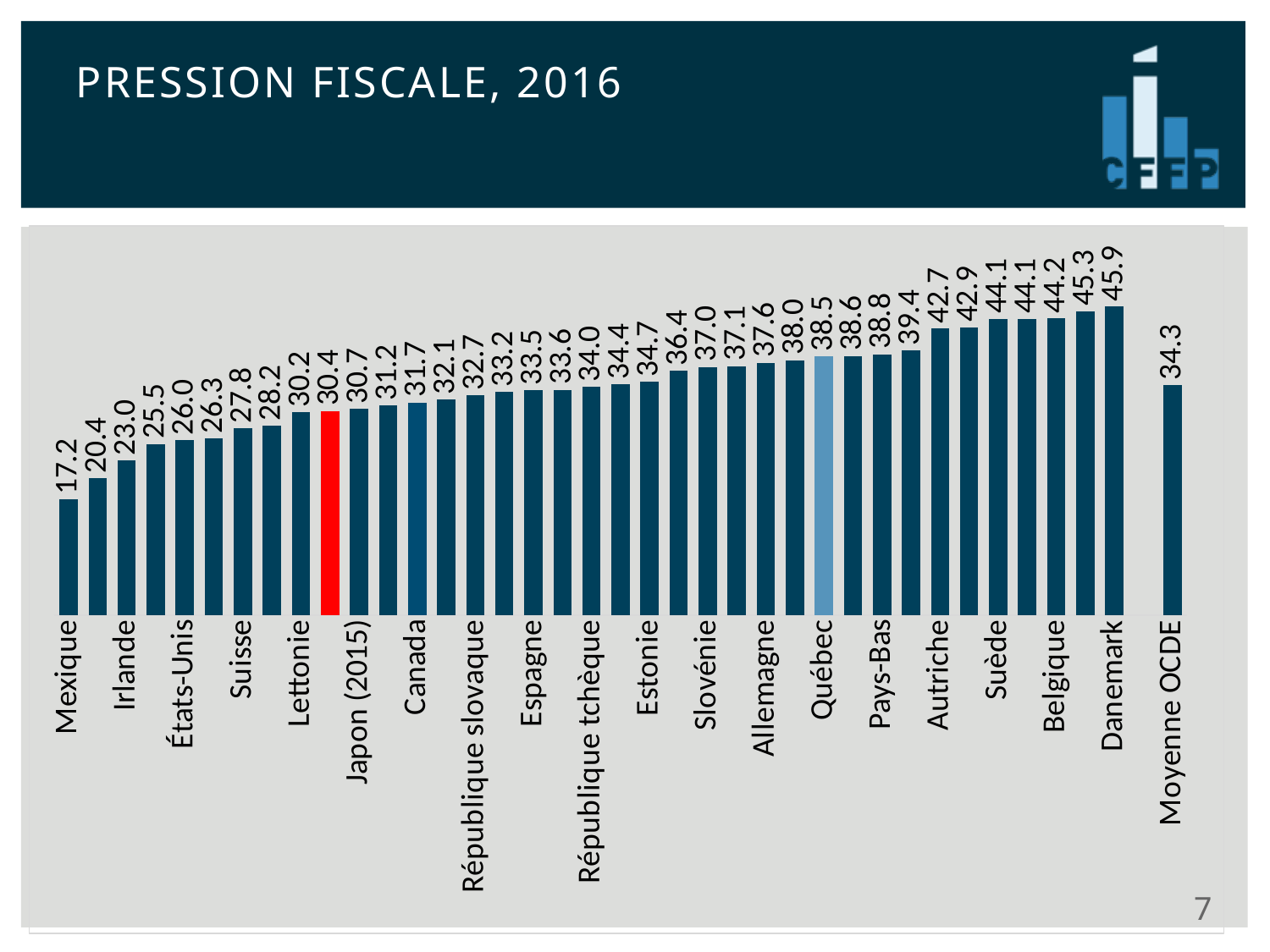
Which labelled category has the lowest value? Mexique Do the values generally rise or fall from left to right across the country bars? rise What is the value for Moyenne OCDE? 34.3 What is the title of the slide containing the chart? PRESSION FISCALE, 2016 What is the difference between the values for Québec and Canada? 6.8 What is the value for Mexique? 17.2 Which labelled category has the highest value? Danemark What is the value for Canada? 31.7 What is the value for Québec? 38.5 What kind of chart is shown on the slide? bar chart Which is larger, the value for Québec or the value for Moyenne OCDE? Québec What is the value for Danemark? 45.9